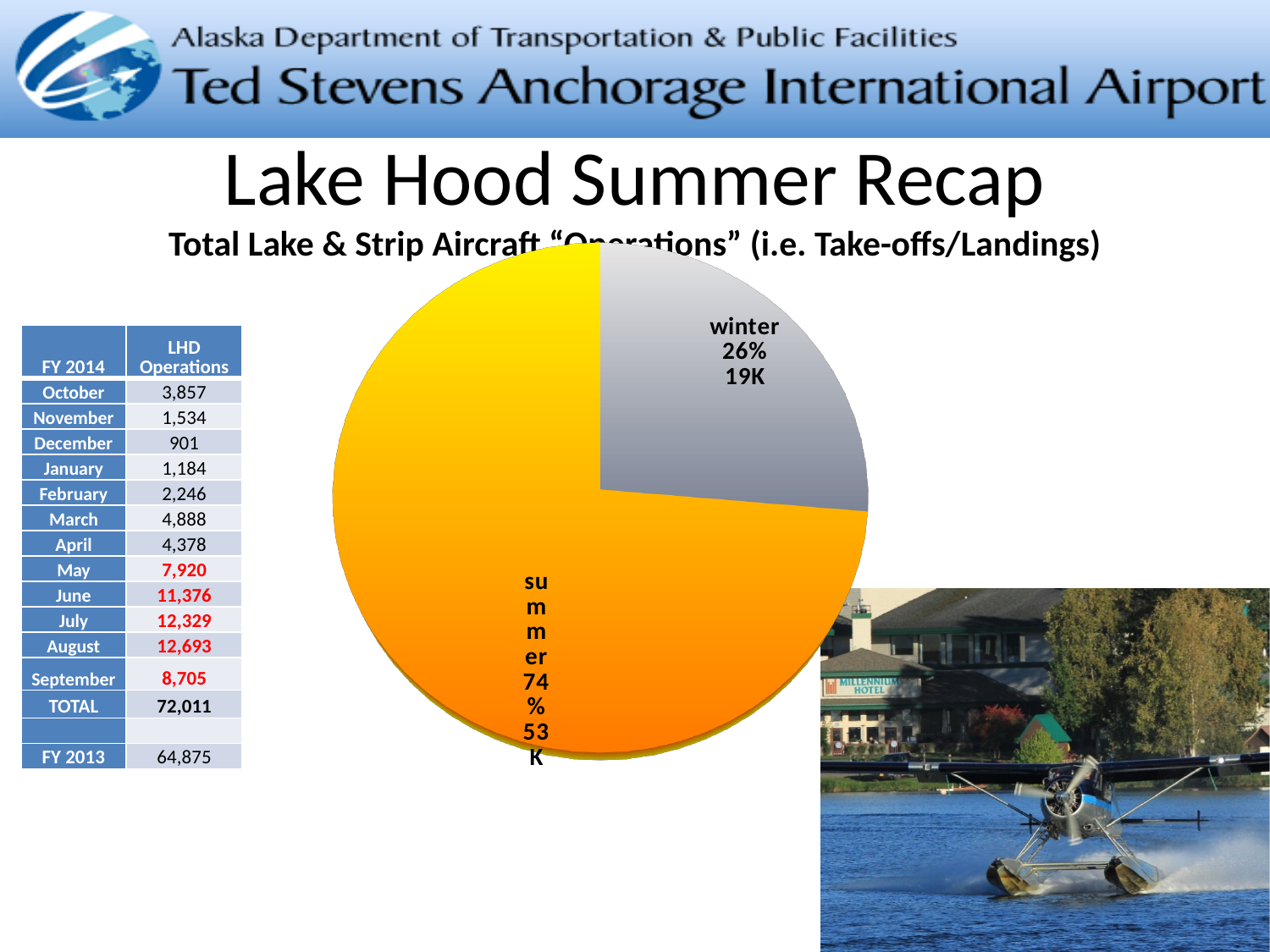
Which slice of the pie chart is the smallest? winter What value is labelled on the winter slice of the pie chart? 19K What share of the pie does the winter slice represent? 26% What share of the pie does the summer slice represent? 74% What value is labelled on the summer slice of the pie chart? 53K What kind of chart is shown on the slide? pie chart What is the difference in percentage share between the summer and winter slices? 48% How many slices does the pie chart have? 2 What colour is the winter slice of the pie chart? grey What is the difference between the summer value (53K) and the winter value (19K) in the pie chart? 34K Which is larger in the pie chart, summer or winter? summer Which slice of the pie chart is the largest? summer